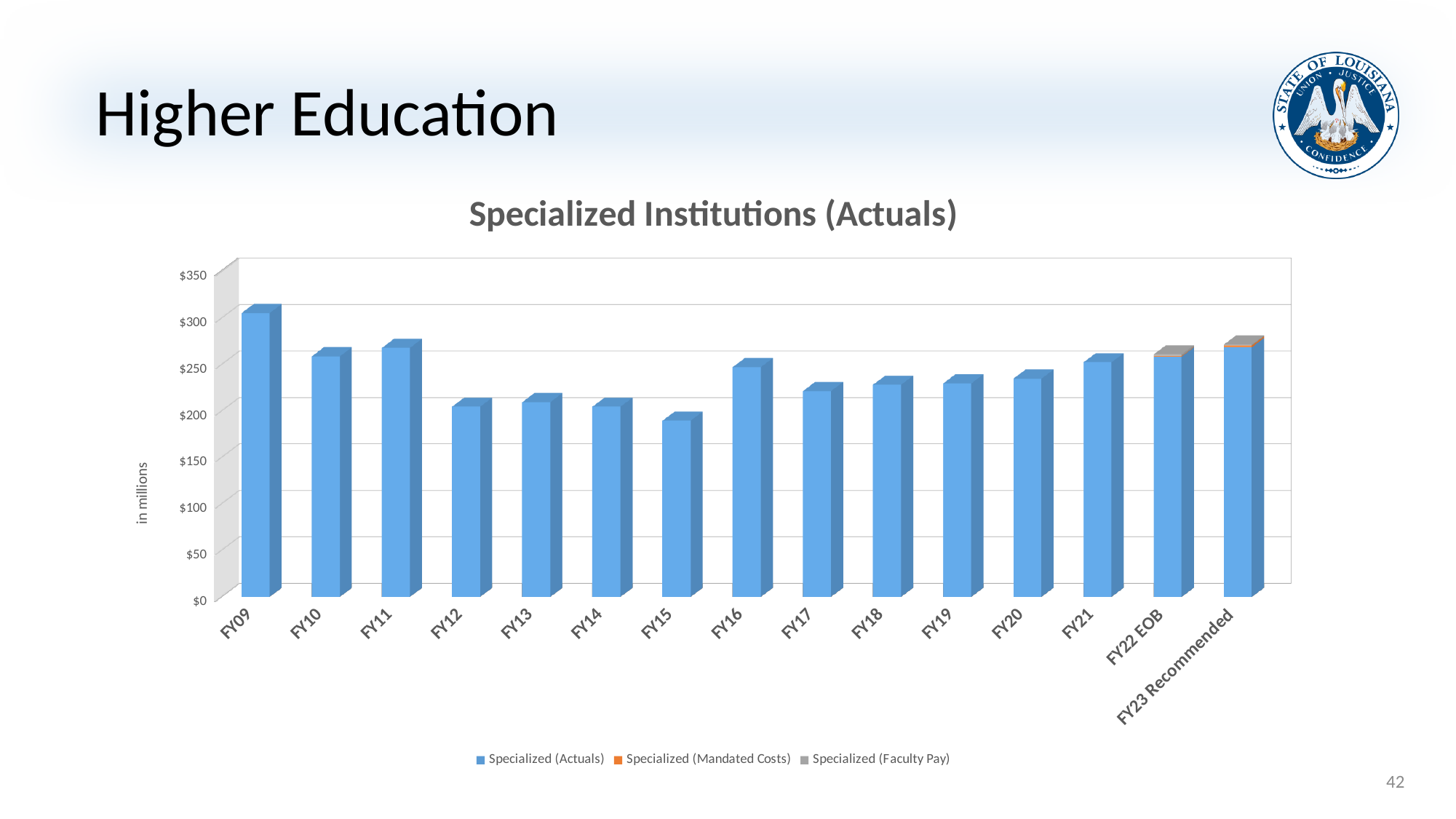
Which is larger, the bar for FY16 or the bar for FY15? FY16 Is the value for FY10 greater or less than $250? greater Which is larger, the bar for FY09 or the bar for FY10? FY09 What is the title of the chart? Specialized Institutions (Actuals) How many series does the legend list? 3 How many fiscal year categories are shown on the x axis? 15 Which fiscal year has the lowest bar? FY15 Which fiscal year has the highest bar? FY09 What type of chart is shown on the slide? bar chart Do the values rise or fall from FY15 to FY21? rise Is the value for FY17 greater or less than $250? less Is the value for FY15 greater or less than $200? less